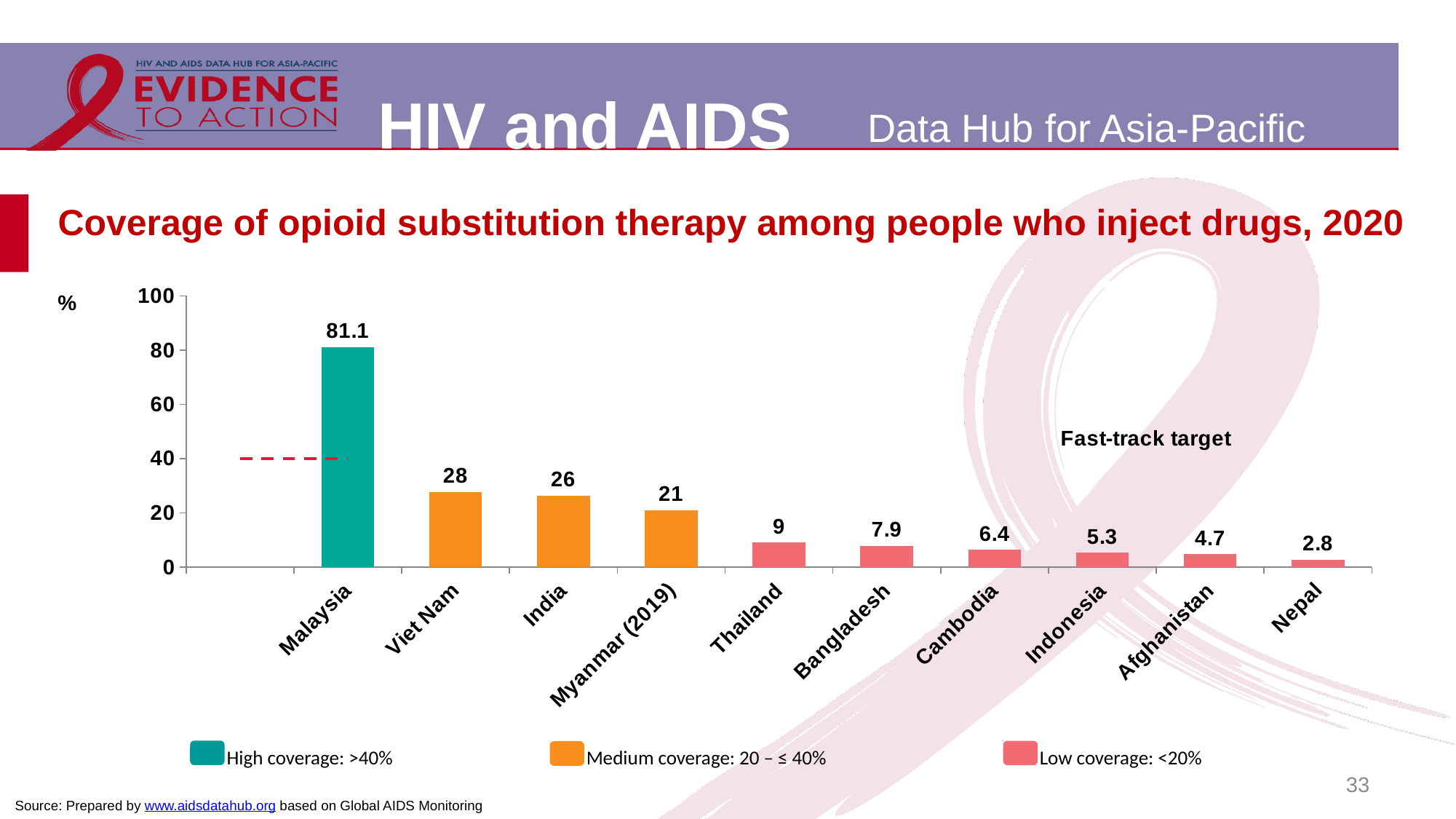
Which country has the highest coverage of opioid substitution therapy? Malaysia What is the value shown for Viet Nam? 28 What is the value shown for Myanmar (2019)? 21 What kind of chart is shown on the slide? Bar chart Which country has the lowest coverage of opioid substitution therapy? Nepal What is the difference between the values for Malaysia and Nepal? 78.3 How many coverage categories does the legend list? 3 How many countries are shown on the chart? 10 What is the difference between the values for Viet Nam and India? 2 Which has a higher value, Thailand or Cambodia? Thailand What is the coverage of opioid substitution therapy for Malaysia? 81.1 What is the value shown for Bangladesh? 7.9